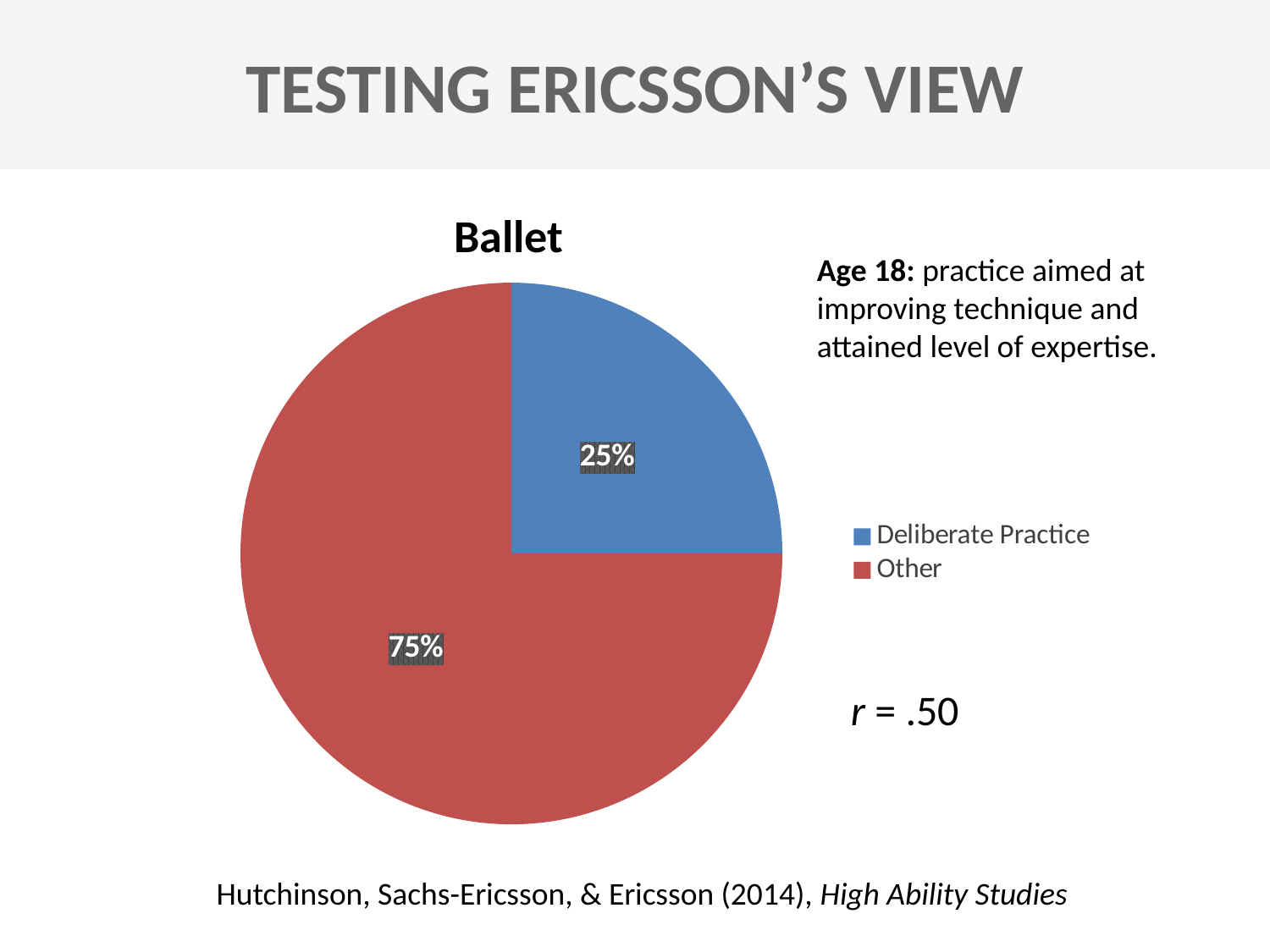
Is the share for Deliberate Practice greater or less than 50%? less Which is larger, the Deliberate Practice slice or the Other slice? Other What is the title of the chart? Ballet What share of the pie does Other take? 75% What colour is the Deliberate Practice slice? blue How many entries does the legend list? 2 Which slice is the largest? Other How many slices does the pie chart have? 2 What kind of chart is shown on the slide? pie chart What share of the pie does Deliberate Practice take? 25% Which slice is the smallest? Deliberate Practice What is the difference in percentage points between the Other slice and the Deliberate Practice slice? 50 percentage points